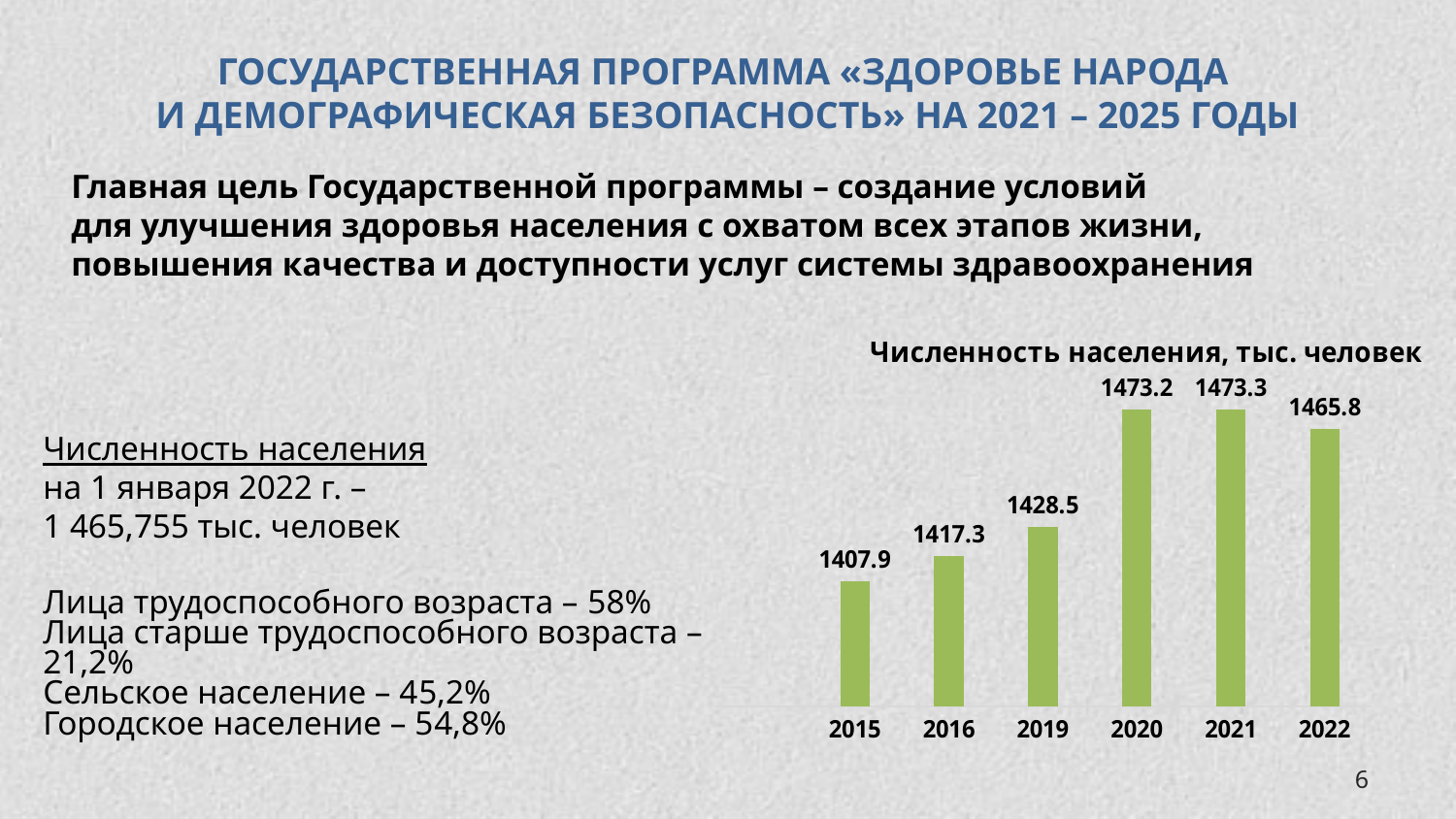
Does the population value rise or fall from 2015 to 2021? Rise What is the population value shown for 2015 in the chart? 1407.9 What is the population value shown for 2022 in the chart? 1465.8 Which year has the lowest population value in the chart? 2015 What kind of chart is used to show the population figures? Bar chart What is the difference between the population values for 2020 and 2019? 44.7 How many years are shown as bars in the chart? 6 What is the population value shown for 2016 in the chart? 1417.3 Which year has the larger population value, 2019 or 2022? 2022 What is the difference between the population values for 2022 and 2015? 57.9 What is the population value shown for 2019 in the chart? 1428.5 What is the title of the chart? Численность населения, тыс. человек